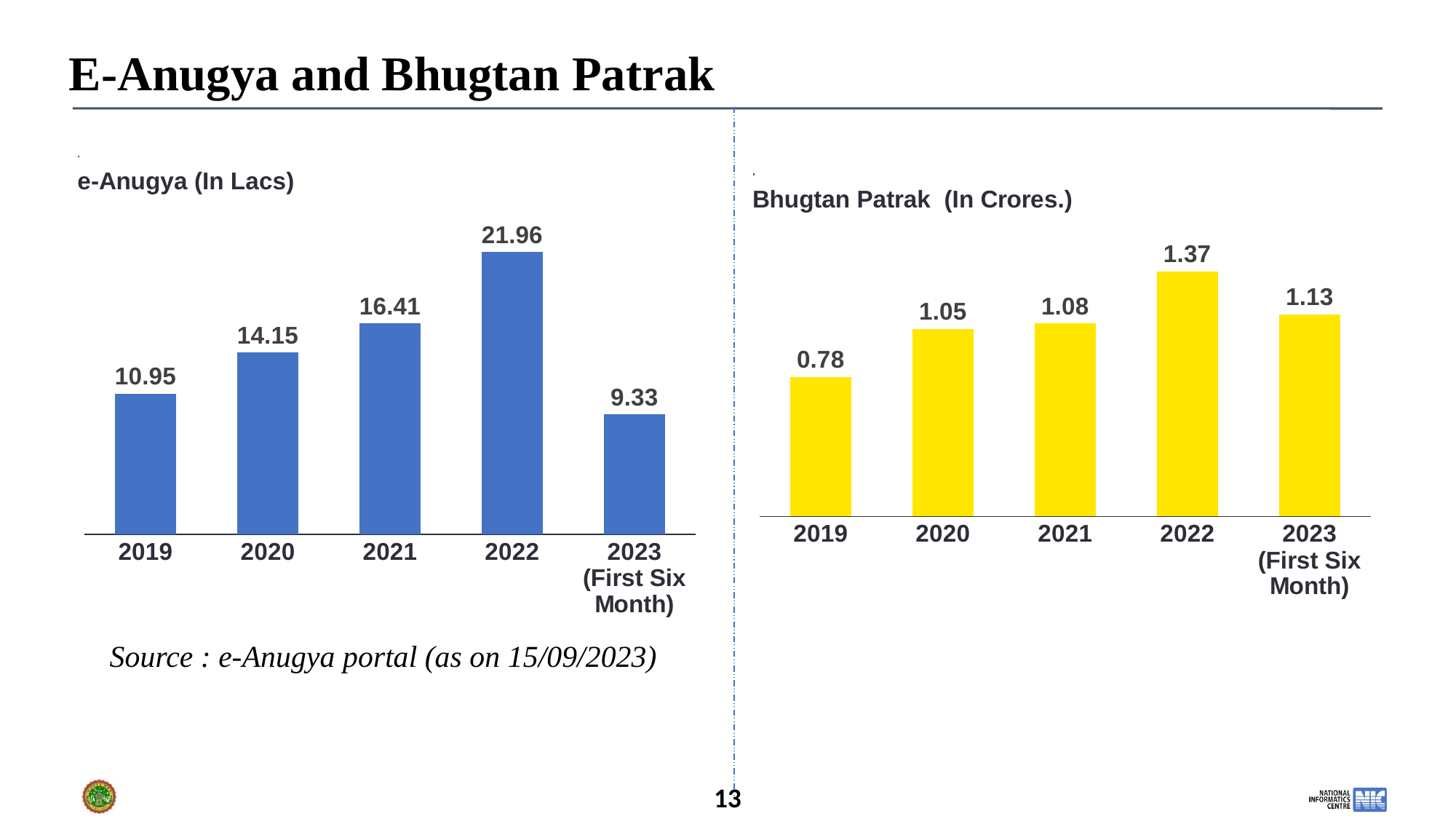
What kind of chart is the e-Anugya (In Lacs) chart? Bar chart What colour are the bars in the Bhugtan Patrak (In Crores.) chart? Yellow In the e-Anugya (In Lacs) chart, do the values rise or fall from 2019 to 2022? Rise How many years are shown on the x axis of the Bhugtan Patrak (In Crores.) chart? 5 In the e-Anugya (In Lacs) chart, what is the value for 2021? 16.41 In the Bhugtan Patrak (In Crores.) chart, which year has the lowest value? 2019 In the Bhugtan Patrak (In Crores.) chart, what is the value for 2022? 1.37 In the e-Anugya (In Lacs) chart, what is the difference between the 2022 and 2019 values? 11.01 In the Bhugtan Patrak (In Crores.) chart, what is the value for 2019? 0.78 In the Bhugtan Patrak (In Crores.) chart, what is the difference between the 2022 and 2023 (First Six Month) values? 0.24 In the e-Anugya (In Lacs) chart, which is larger, the value for 2020 or the value for 2023 (First Six Month)? 2020 In the e-Anugya (In Lacs) chart, which year has the highest value? 2022